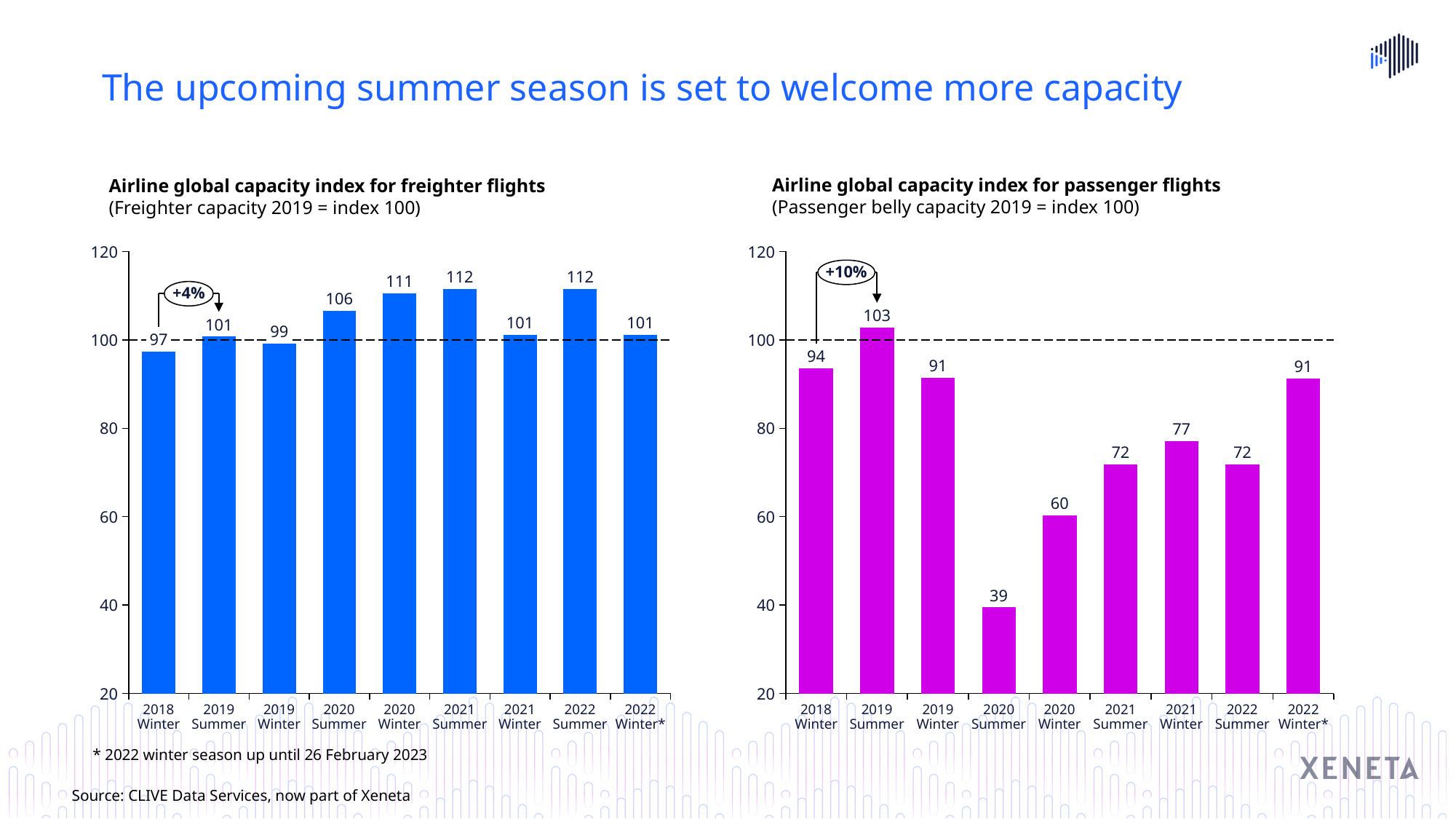
In the freighter flights chart, what is the difference between the 2021 Summer and 2021 Winter values? 11 In the passenger flights chart, what is the capacity index for 2020 Summer? 39 In the passenger flights chart, which is larger: the value for 2021 Winter or 2022 Summer? 2021 Winter In the passenger flights chart, what percentage change is annotated between 2018 Winter and 2019 Summer? +10% What type of chart is the passenger flights chart? Bar chart In the passenger flights chart, which season has the highest capacity index? 2019 Summer How many seasons are shown on the x axis of the freighter flights chart? 9 In the passenger flights chart, which season has the lowest capacity index? 2020 Summer What is the title of the left chart? Airline global capacity index for freighter flights In the freighter flights chart, what is the capacity index for 2020 Summer? 106 In the freighter flights chart, which season has the lowest capacity index? 2018 Winter In the passenger flights chart, what is the difference between the 2019 Summer and 2020 Summer values? 64